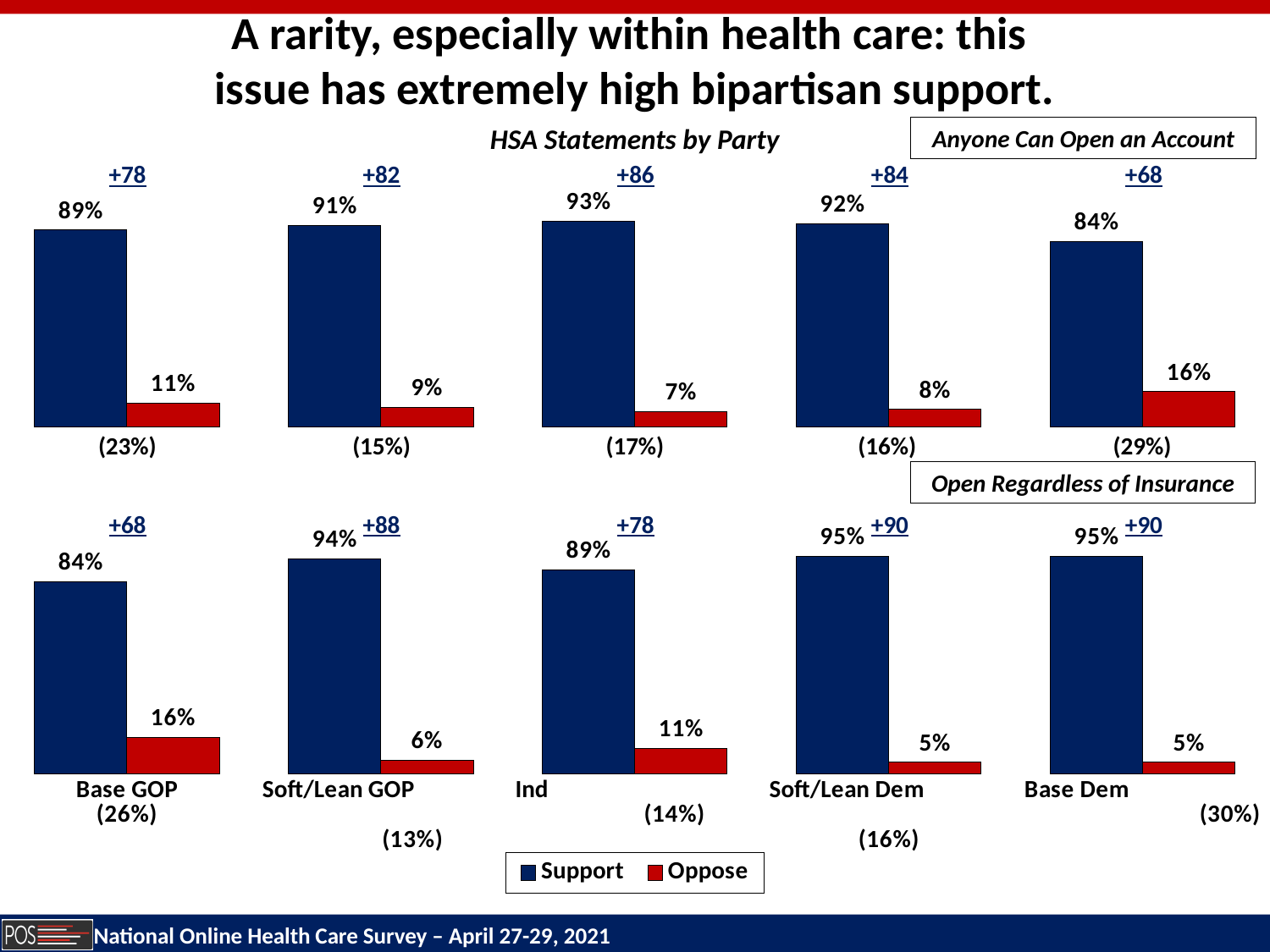
In the 'Anyone Can Open an Account' chart, what is the Oppose value for Base Dem? 16% In the 'Anyone Can Open an Account' chart, which party group has the lowest Support value? Base Dem In the 'Open Regardless of Insurance' chart, which party group has the highest Oppose value? Base GOP In the 'Open Regardless of Insurance' chart, what is the difference between the Support and Oppose values for Base GOP? 68 In the 'Anyone Can Open an Account' chart, is the Support value for Soft/Lean GOP or for Soft/Lean Dem larger? Soft/Lean Dem How many series does the legend list? 2 In the 'Anyone Can Open an Account' chart, what is the Support value for Ind? 93% In the 'Open Regardless of Insurance' chart, what is the Oppose value for Ind? 11% In the 'Open Regardless of Insurance' chart, what is the Support value for Soft/Lean GOP? 94% In the 'Anyone Can Open an Account' chart, which party group has the highest Support value? Ind How many party groups are shown in the 'Open Regardless of Insurance' chart? 5 What type of chart is used for 'Anyone Can Open an Account'? Bar chart